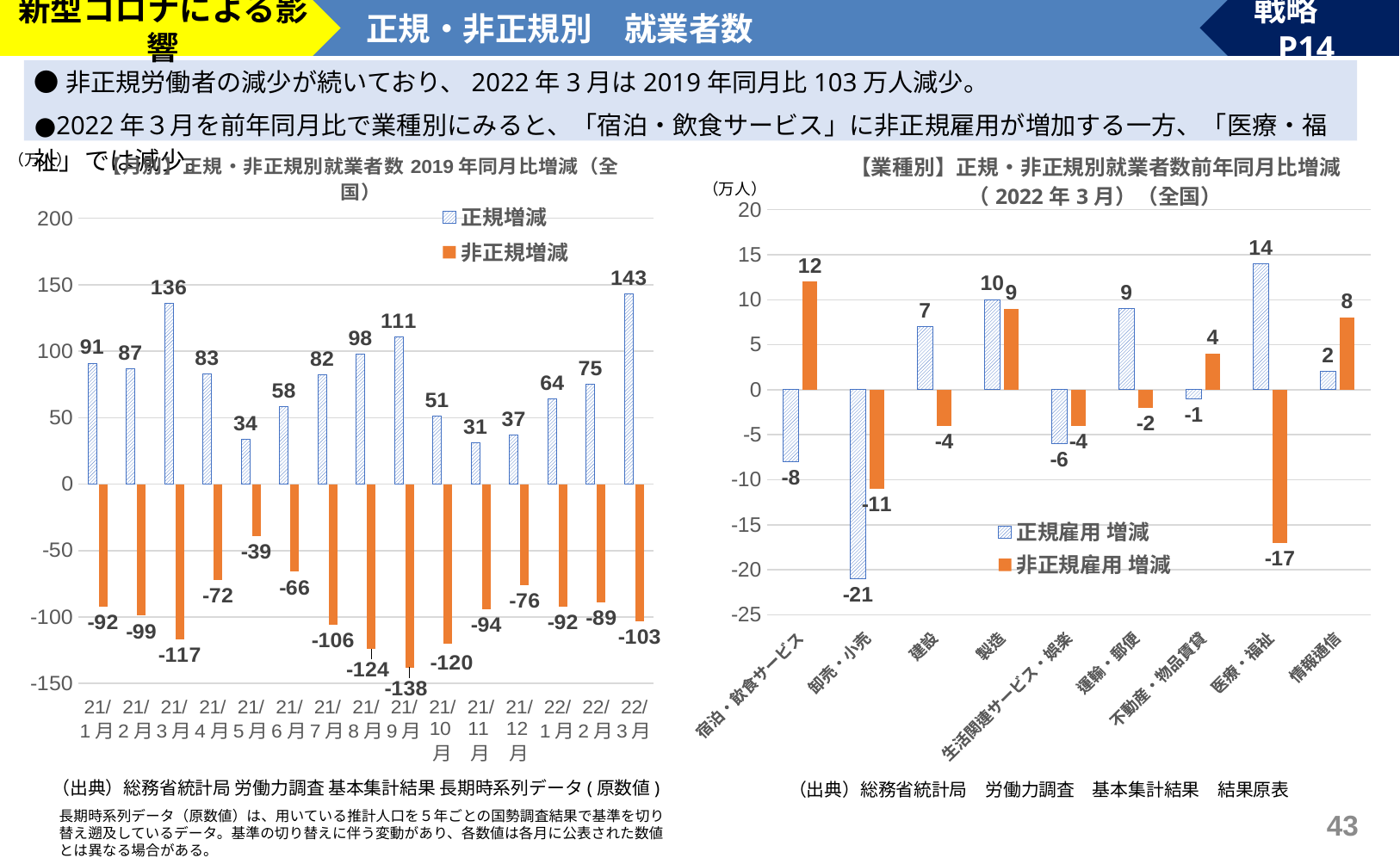
In the right chart, what is the 非正規雇用 増減 value for 医療・福祉? -17 In the right chart, is the 正規雇用 増減 value larger for 製造 or for 建設? 製造 In the left chart, which month has the lowest 非正規増減 value? 21/9月 In the left chart, what is the difference between the 正規増減 values for 21/3月 and 21/5月? 102 How many months are shown on the x axis of the left chart? 15 In the left chart, which month has the highest 正規増減 value? 22/3月 What type of chart is the right chart? Bar chart In the left chart, what is the value of 正規増減 for 22/3月? 143 In the left chart, what is the value of 非正規増減 for 21/9月? -138 How many series does the legend of the right chart list? 2 In the right chart, what is the 正規雇用 増減 value for 卸売・小売? -21 In the right chart, which industry has the highest 非正規雇用 増減 value? 宿泊・飲食サービス